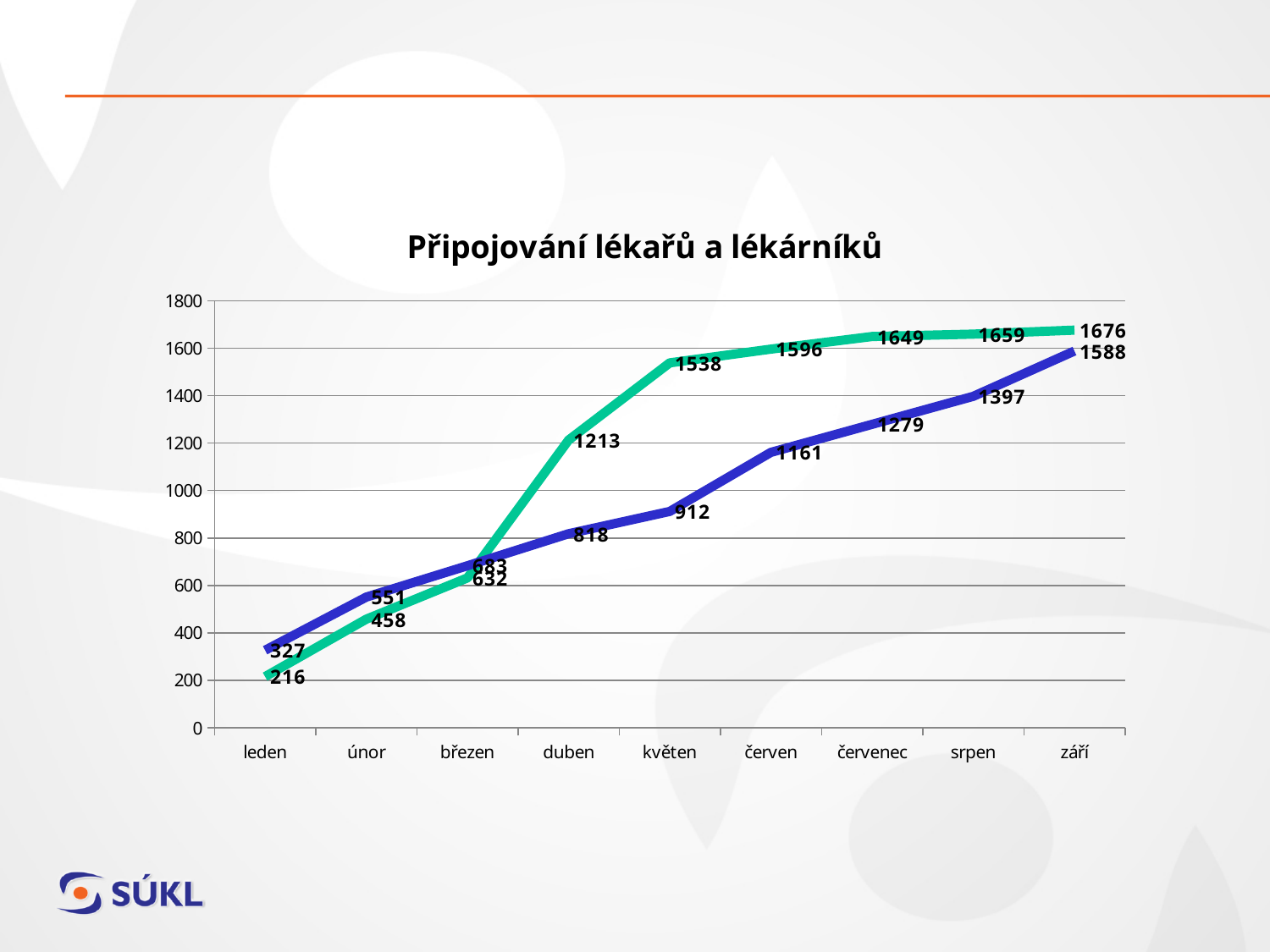
What is the difference between the green line and the blue line in duben? 395 In which month does the blue line have its lowest value? leden In which month does the green line reach its highest value? září What is the value of the green line in květen? 1538 How many months are shown on the x axis of the chart? 9 What is the title of the chart? Připojování lékařů a lékárníků What is the value of the blue line in září? 1588 What is the value of the blue line in červen? 1161 Which line has the higher value in únor, the blue line or the green line? blue line What is the value of the green line in leden? 216 Does the blue line rise or fall from leden to září? rise What kind of chart is shown on the slide? line chart